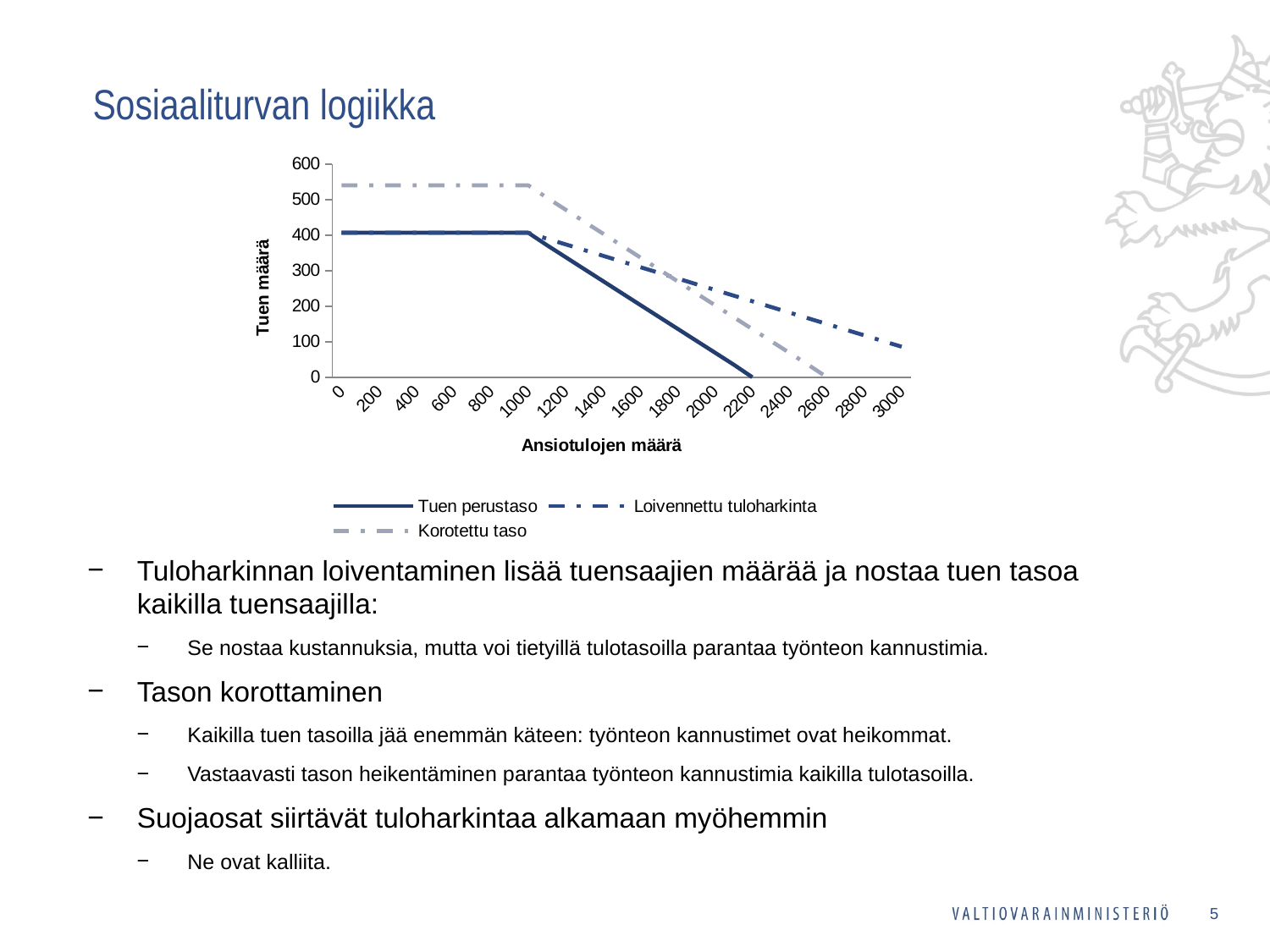
Does the Tuen perustaso line rise or fall as income increases beyond 1000? fall How many tick labels are shown on the x axis of the chart? 16 Is the value of Loivennettu tuloharkinta at an income of 3000 greater or less than 200? less At an income of 2400, which is larger: Loivennettu tuloharkinta or Korotettu taso? Loivennettu tuloharkinta What is the title of the y axis of the chart? Tuen määrä Is the value of Tuen perustaso at an income of 2000 greater or less than 200? less How many series does the chart legend list? 3 Is the value of Tuen perustaso at an income of 0 greater or less than 300? greater What is the title of the x axis of the chart? Ansiotulojen määrä Which series has the highest value at an income of 0? Korotettu taso What kind of chart is shown on the slide? line chart